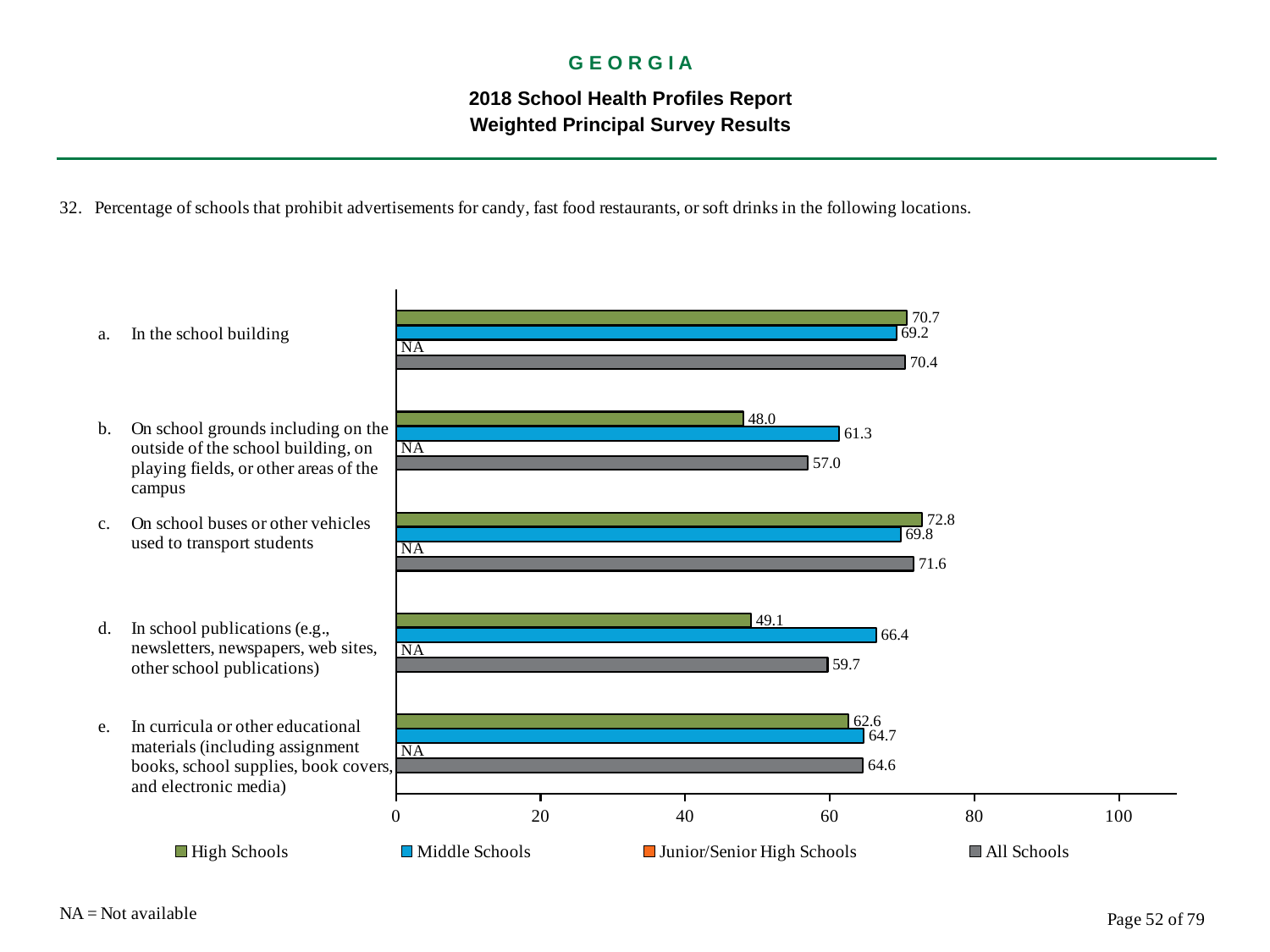
What is the value for Middle Schools for 'In school publications (e.g., newsletters, newspapers, web sites, other school publications)'? 66.4 Which location has the highest value for High Schools? On school buses or other vehicles used to transport students How many locations (categories) are shown in the chart? 5 What is shown for Junior/Senior High Schools for 'On school buses or other vehicles used to transport students'? NA What is the difference between the Middle Schools and High Schools values for 'In school publications'? 17.3 What is the value for All Schools for 'On school grounds including on the outside of the school building, on playing fields, or other areas of the campus'? 57.0 For 'In curricula or other educational materials', which is larger: the High Schools value or the Middle Schools value? Middle Schools What does NA stand for according to the note on the slide? Not available What kind of chart is shown on the slide? Bar chart What is the value for High Schools for 'In the school building'? 70.7 Which location has the lowest value for High Schools? On school grounds including on the outside of the school building, on playing fields, or other areas of the campus How many series does the legend list? 4